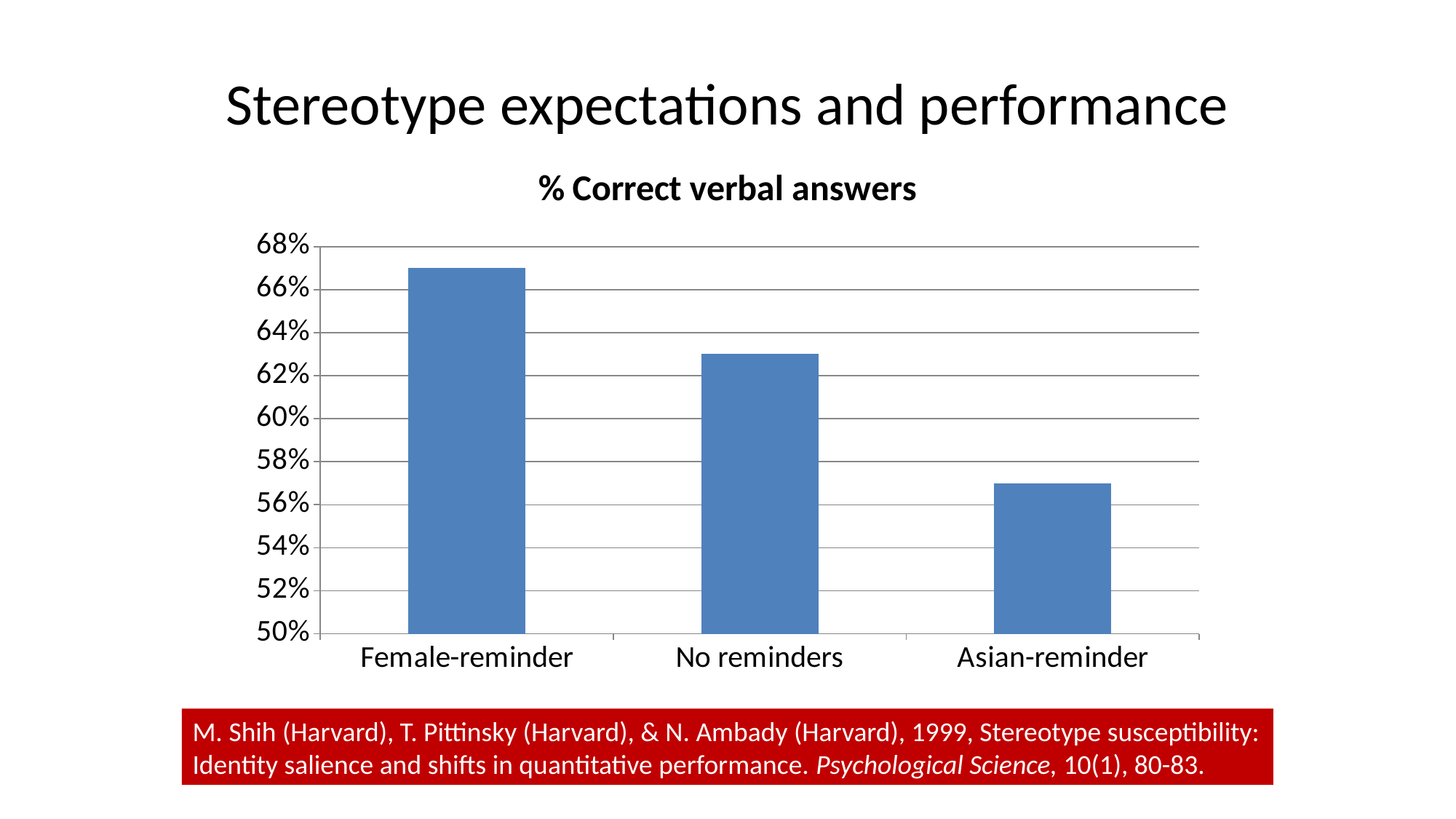
What kind of chart is shown on the slide? bar chart Which is larger, the value for No reminders or the value for Asian-reminder? No reminders Do the values rise or fall from left to right across the categories? fall Is the value for Asian-reminder greater or less than 56%? greater Is the value for Asian-reminder greater or less than 58%? less How many categories are plotted in the chart? 3 Is the value for Female-reminder greater or less than 66%? greater What is the title of the chart? % Correct verbal answers Which category has the lowest % correct verbal answers? Asian-reminder Which category has the highest % correct verbal answers? Female-reminder What is the lowest value shown on the vertical axis? 50%